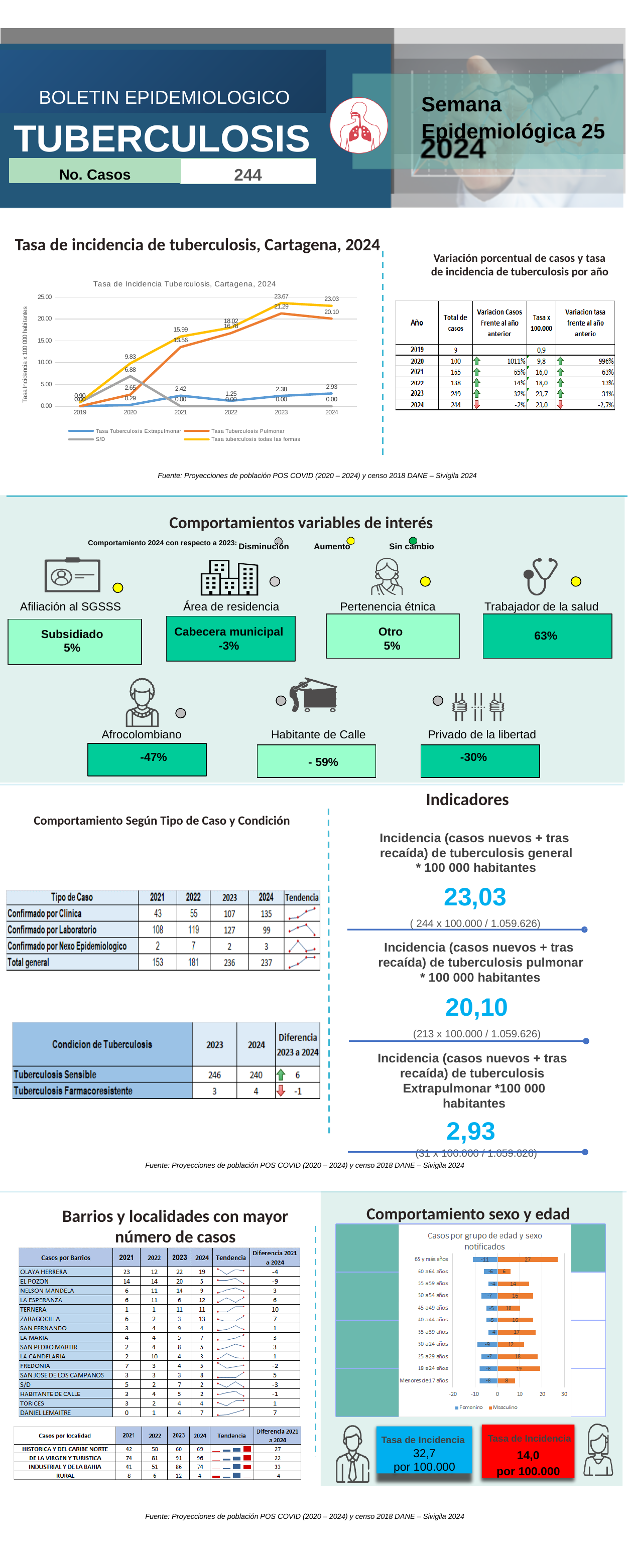
What kind of chart is 'Casos por grupo de edad y sexo notificados'? bar chart In the line chart 'Tasa de Incidencia Tuberculosis, Cartagena, 2024', how many series does the legend list? 4 In the bar chart 'Casos por grupo de edad y sexo notificados', how many series does the legend list? 2 In the line chart 'Tasa de Incidencia Tuberculosis, Cartagena, 2024', does 'Tasa Tuberculosis Pulmonar' rise or fall from 2019 to 2023? rise In the line chart 'Tasa de Incidencia Tuberculosis, Cartagena, 2024', how many years are shown on the x axis? 6 In the bar chart 'Casos por grupo de edad y sexo notificados', what is the Masculino value for '65 y más años'? 27 In the line chart 'Tasa de Incidencia Tuberculosis, Cartagena, 2024', what is the value of 'Tasa Tuberculosis Pulmonar' in 2024? 20.10 In the bar chart 'Casos por grupo de edad y sexo notificados', which age group has the highest Masculino value? 65 y más años In the line chart 'Tasa de Incidencia Tuberculosis, Cartagena, 2024', what is the value of 'Tasa Tuberculosis Extrapulmonar' in 2024? 2.93 In the line chart 'Tasa de Incidencia Tuberculosis, Cartagena, 2024', what is the value of 'Tasa tuberculosis todas las formas' in 2023? 23.67 In the line chart 'Tasa de Incidencia Tuberculosis, Cartagena, 2024', what is the difference between 'Tasa tuberculosis todas las formas' and 'Tasa Tuberculosis Pulmonar' in 2024? 2.93 In the line chart 'Tasa de Incidencia Tuberculosis, Cartagena, 2024', in which year does 'Tasa tuberculosis todas las formas' reach its highest value? 2023